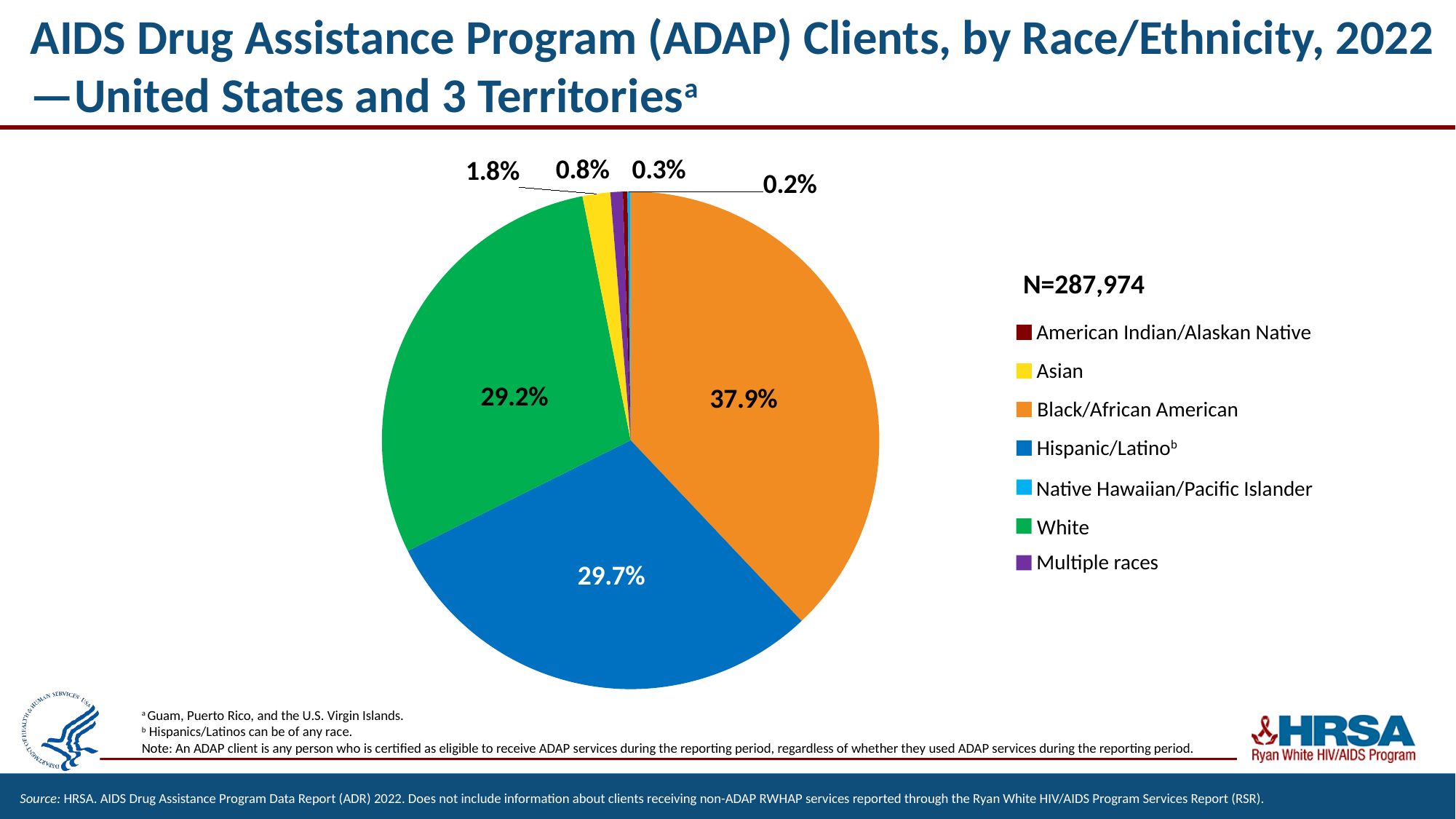
What percentage of ADAP clients are Black/African American? 37.9% What percentage of ADAP clients are Hispanic/Latino? 29.7% Which group has a larger share of ADAP clients, Hispanic/Latino or White? Hispanic/Latino How many race/ethnicity categories does the legend list? 7 What colour represents the White category in the pie chart? green What percentage of ADAP clients are Asian? 1.8% What type of chart is shown on the slide? pie chart Which race/ethnicity group has the smallest share of ADAP clients? Native Hawaiian/Pacific Islander What is the total number of ADAP clients (N) shown on the slide? 287,974 Which race/ethnicity group has the largest share of ADAP clients? Black/African American What percentage of ADAP clients are White? 29.2% What is the difference in percentage points between the Black/African American share and the White share? 8.7